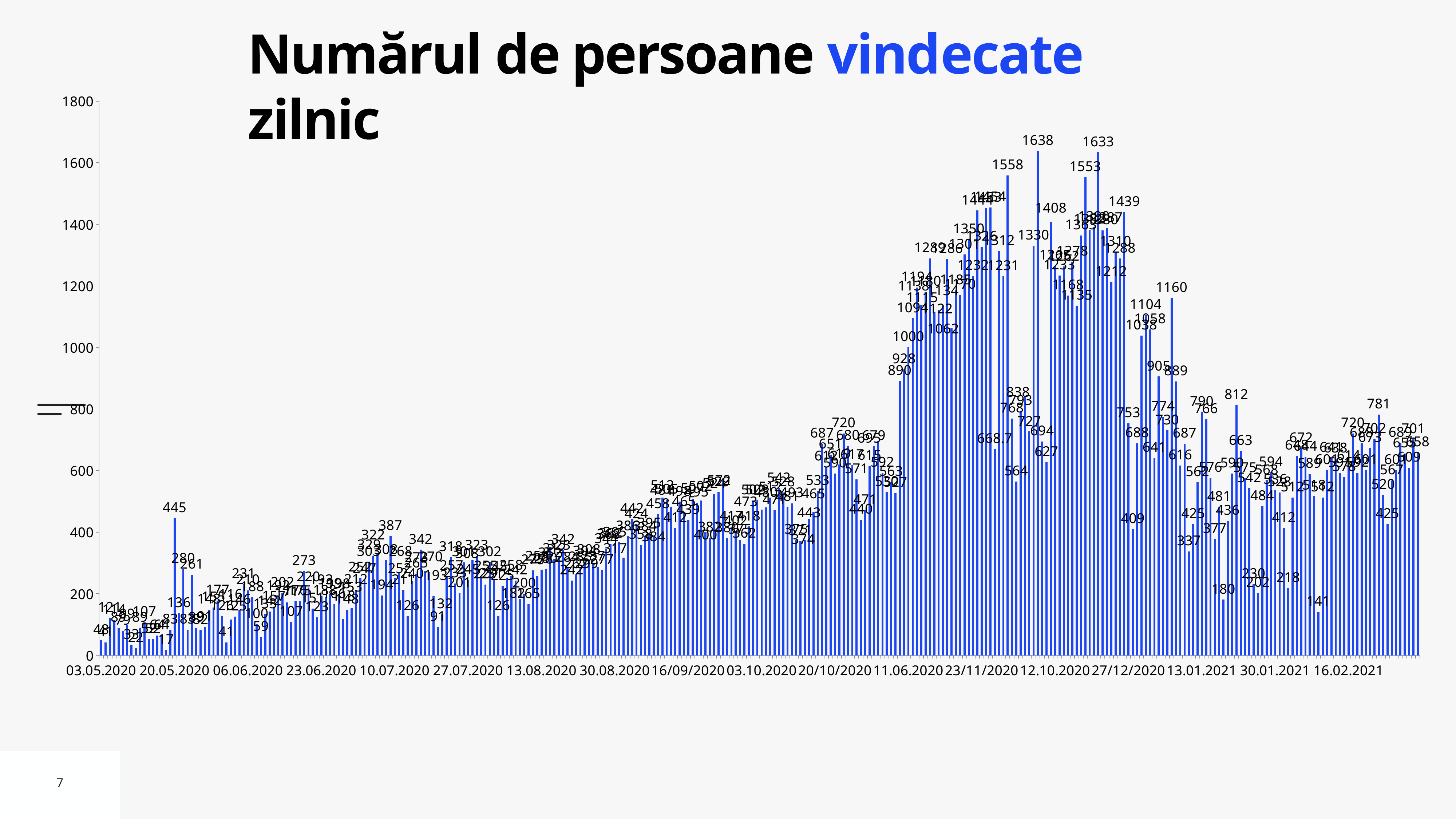
Do the daily values generally rise or fall from May 2020 to late 2020? rise What is the maximum value shown on the vertical axis? 1800 What is the title of the chart? Numărul de persoane vindecate zilnic Is the highest value on the chart greater or less than 1600? greater What kind of chart is shown on the slide? bar chart Is the peak labelled 445 near 20.05.2020 greater or less than 400? greater Is the value labelled 812 greater or less than 800? greater What is the difference between the two tallest peaks, 1638 and 1633? 5 What is the highest daily value labelled on the chart? 1638 Which is larger, the peak labelled 1638 or the peak labelled 1633? 1638 What is the difference between the peak labelled 1638 and the peak labelled 1558? 80